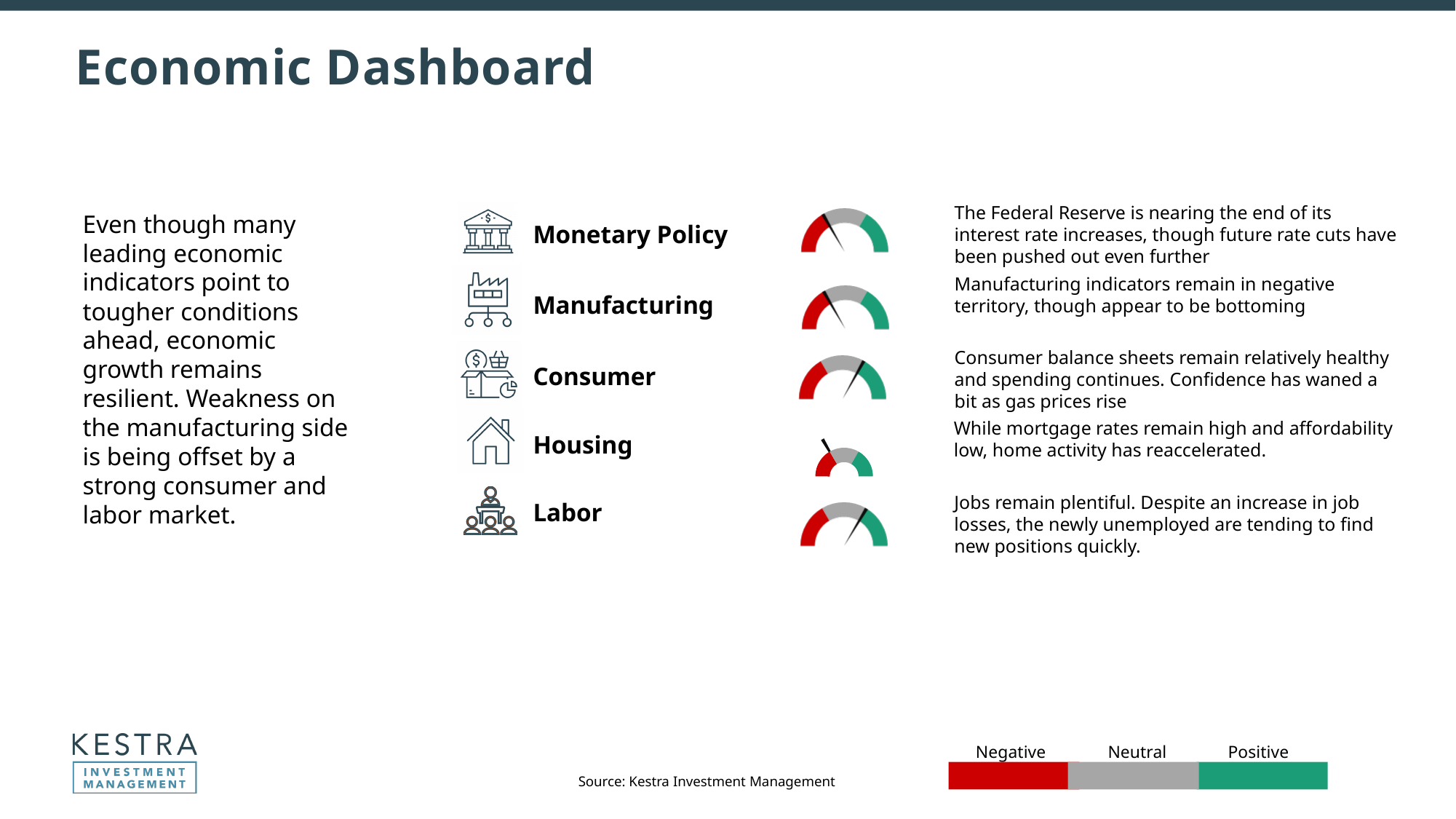
Which indicator is rated more positively, Housing or Labor? Labor Which indicator's gauge needle points furthest into the negative zone? Housing Which indicator is rated more negatively, Manufacturing or Consumer? Manufacturing What is the last indicator listed on the dashboard? Labor What kind of chart is used to show each indicator's status? Gauge chart Is the Labor gauge needle in the positive or negative zone? Positive How many categories does the colour legend at the bottom list? 3 How many economic indicators are shown with gauges on the slide? 5 What does the red colour on the gauges represent according to the legend? Negative Which zone does the Housing gauge needle point to? Negative What does the green colour on the gauges represent according to the legend? Positive What is the first indicator listed on the dashboard? Monetary Policy